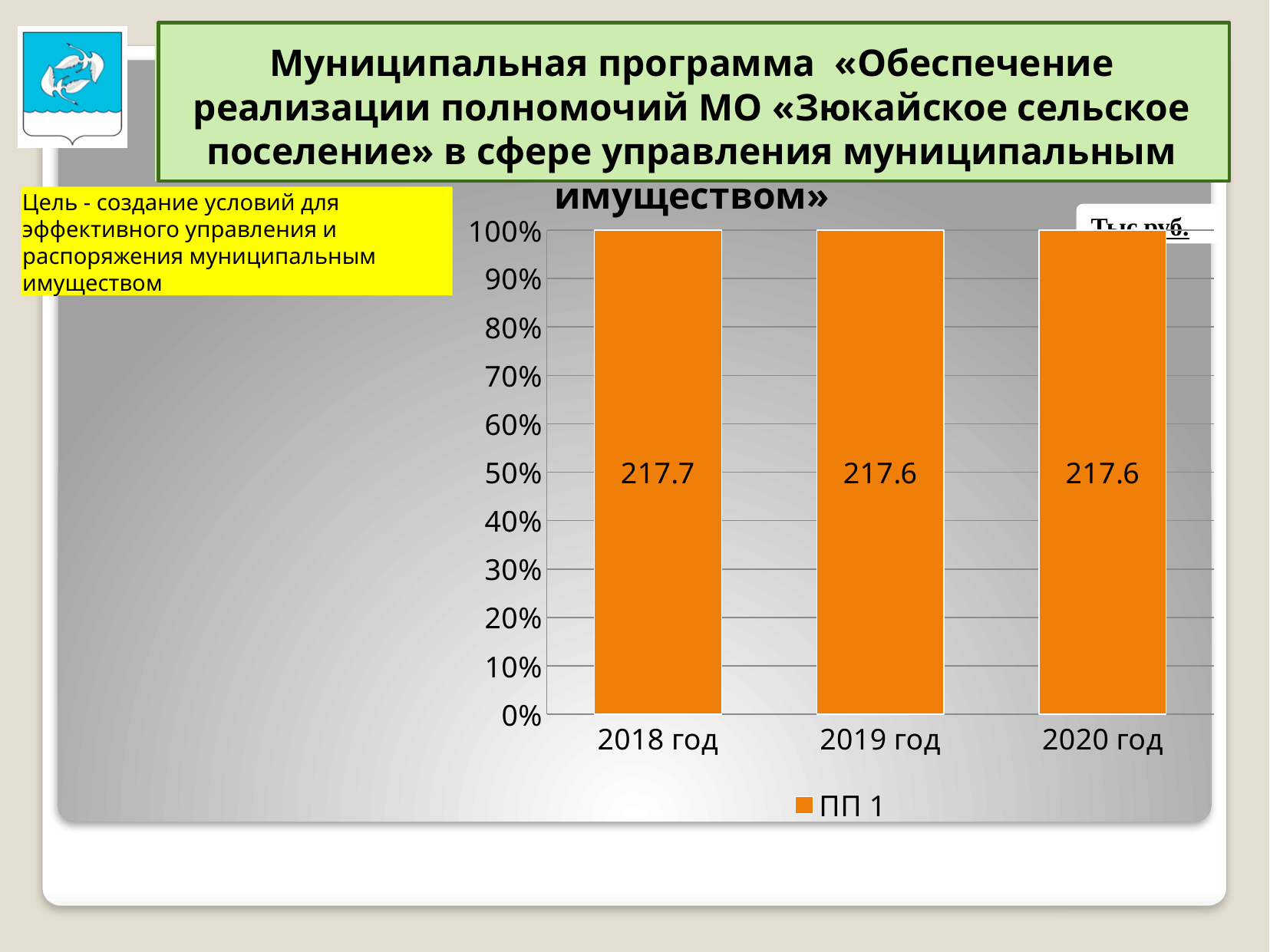
What is the value for 2019 год? 217.6 Which is larger according to the data labels: the value for 2018 год or the value for 2020 год? 2018 год Which year has the highest value according to the data labels? 2018 год How many series does the legend list? 1 What is the value for 2018 год? 217.7 What is the difference between the values for 2018 год and 2019 год? 0.1 What kind of chart is shown on the slide? bar chart What is the name of the series in the legend? ПП 1 Do the data label values rise or fall from 2018 год to 2019 год? fall What unit is indicated in the box at the top right of the chart? Тыс руб. How many categories are shown on the x axis? 3 What is the value for 2020 год? 217.6